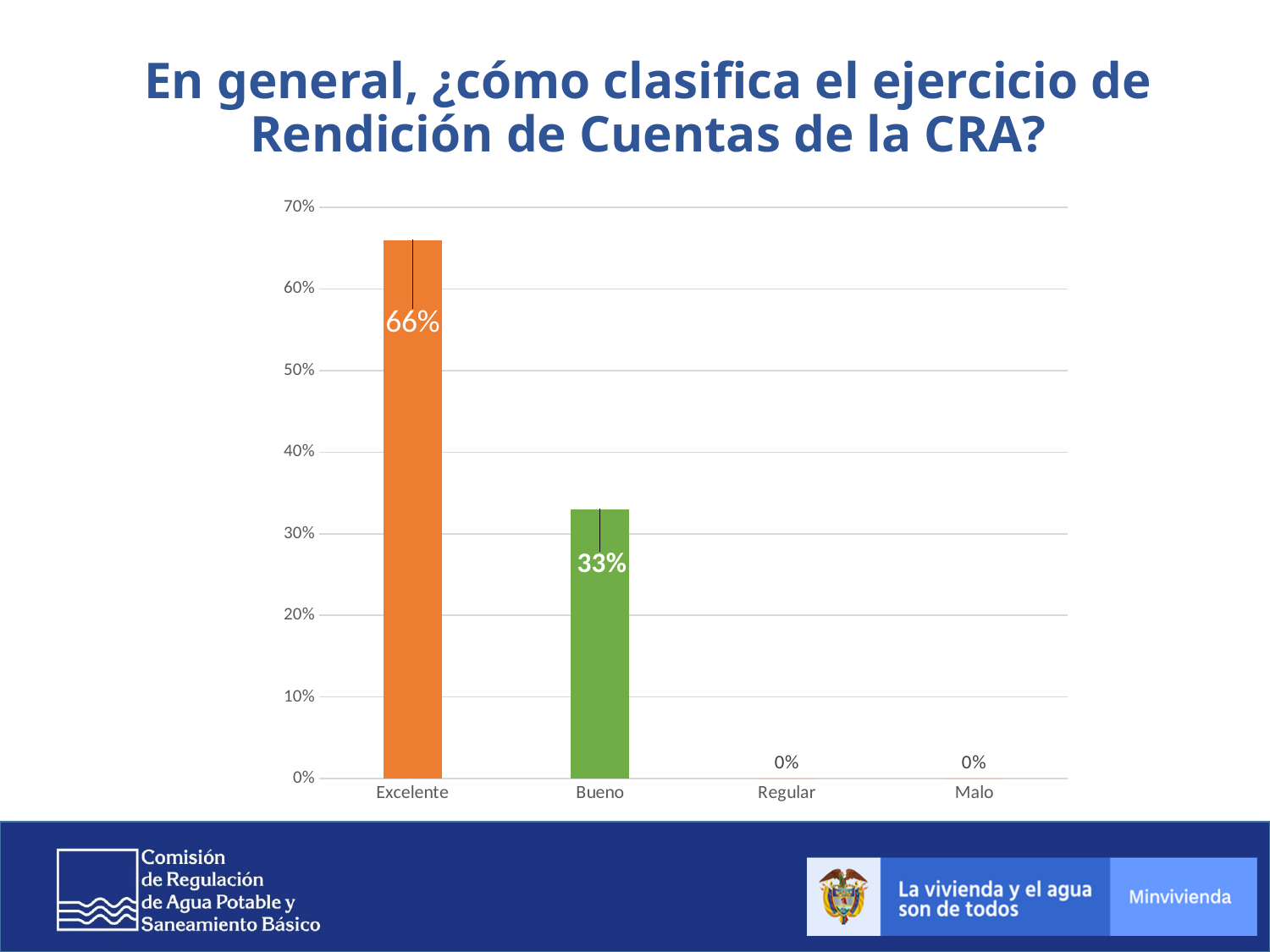
How many categories are shown on the x axis? 4 What is the value for Regular? 0% What is the value for Excelente? 66% Which is larger, the value for Bueno or the value for Excelente? Excelente Is the value for Bueno greater or less than 40%? less What is the value for Malo? 0% What is the value for Bueno? 33% Which category has the highest value? Excelente What is the difference between the values for Excelente and Bueno? 33% Do the values rise or fall from Excelente to Malo along the x axis? fall What colour is the bar for Bueno? green What kind of chart is shown on the slide? bar chart